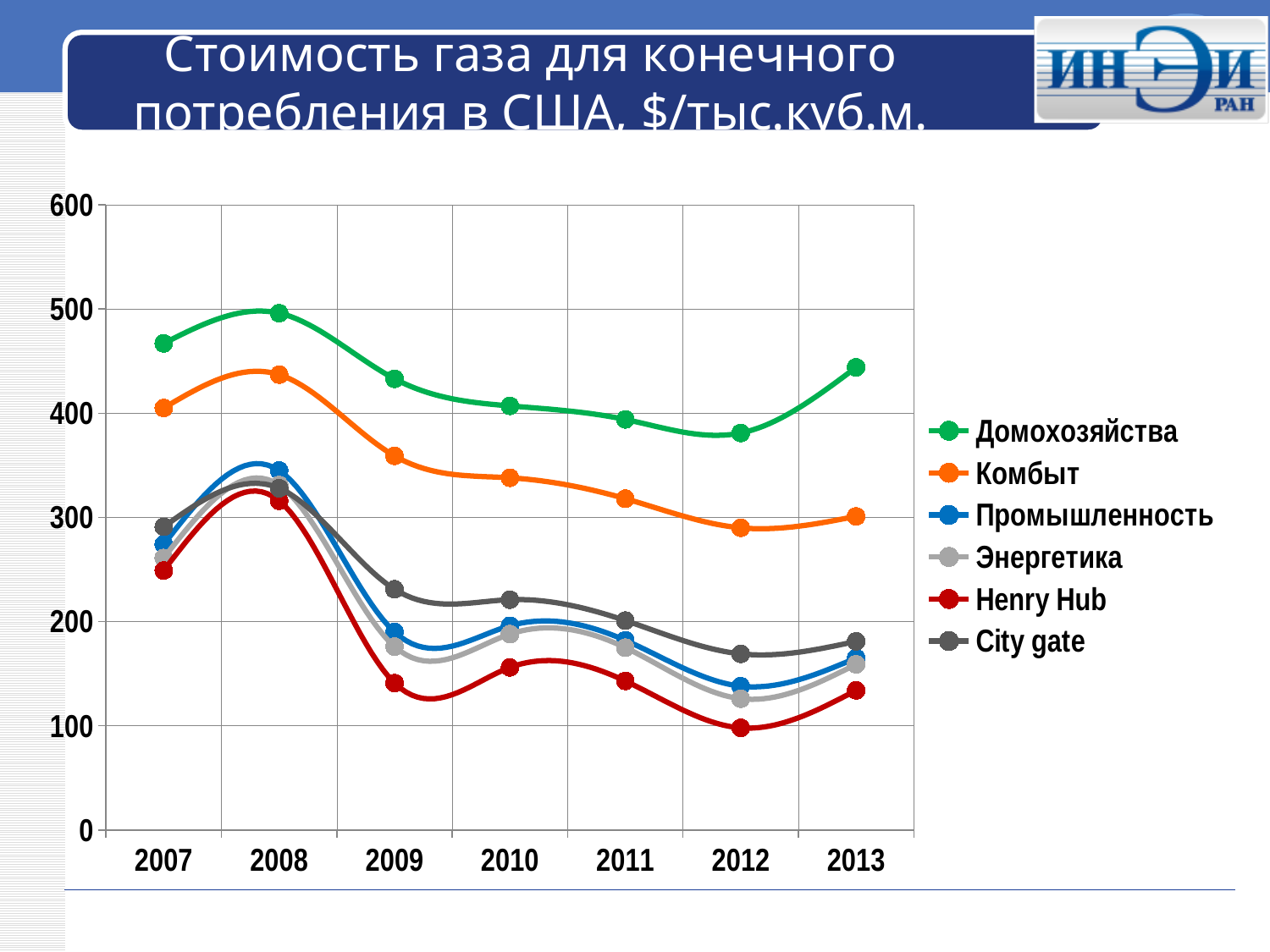
What colour is the Henry Hub line in the legend? red What kind of chart is shown on the slide? line chart In which year does the Henry Hub series reach its lowest value? 2012 Is the value for Домохозяйства in 2008 greater or less than 400? greater How many series does the legend list? 6 Is the value for Henry Hub in 2009 greater or less than 200? less In 2013, which is larger: Комбыт or Промышленность? Комбыт Which series has the lowest value in 2012? Henry Hub Which series has the highest value in 2008? Домохозяйства Does the Домохозяйства line rise or fall from 2008 to 2012? falls In which year does the Домохозяйства series reach its highest value? 2008 How many years are plotted along the x axis? 7